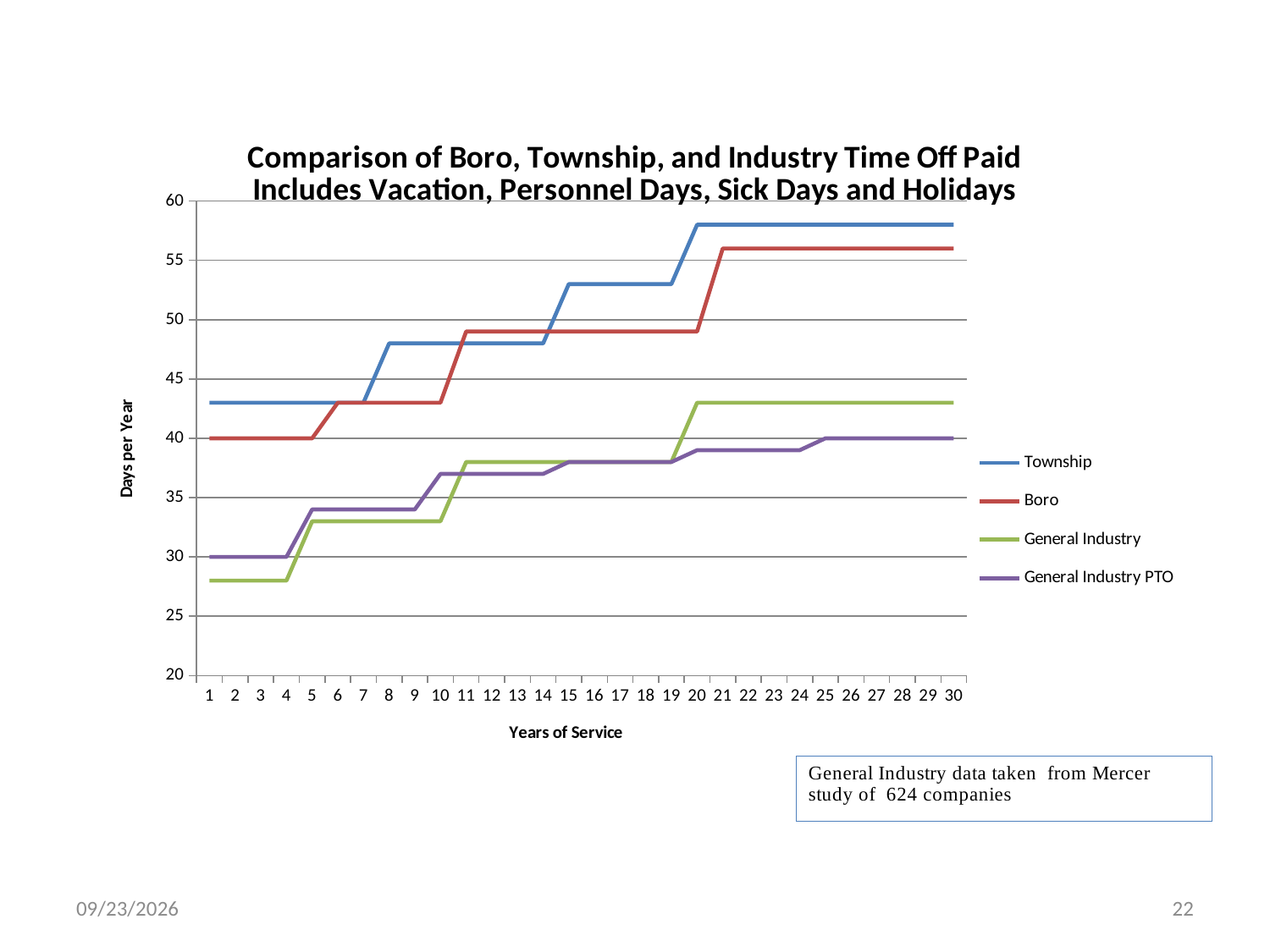
Is the value for General Industry at year 1 greater or less than 30? less What is the value for Boro at year 1 of service? 40 What is the value for General Industry PTO at year 1 of service? 30 Which series has the highest value at year 30 of service? Township What kind of chart is shown on the slide? Line chart How many years of service are shown along the x axis? 30 Do the values for Township rise or fall as years of service increase? Rise How many series does the legend list? 4 Is the value for Township at year 30 greater or less than 55? greater What is the value for General Industry PTO at year 30 of service? 40 At year 30 of service, which is larger, Township or Boro? Township Which series has the lowest value at year 30 of service? General Industry PTO